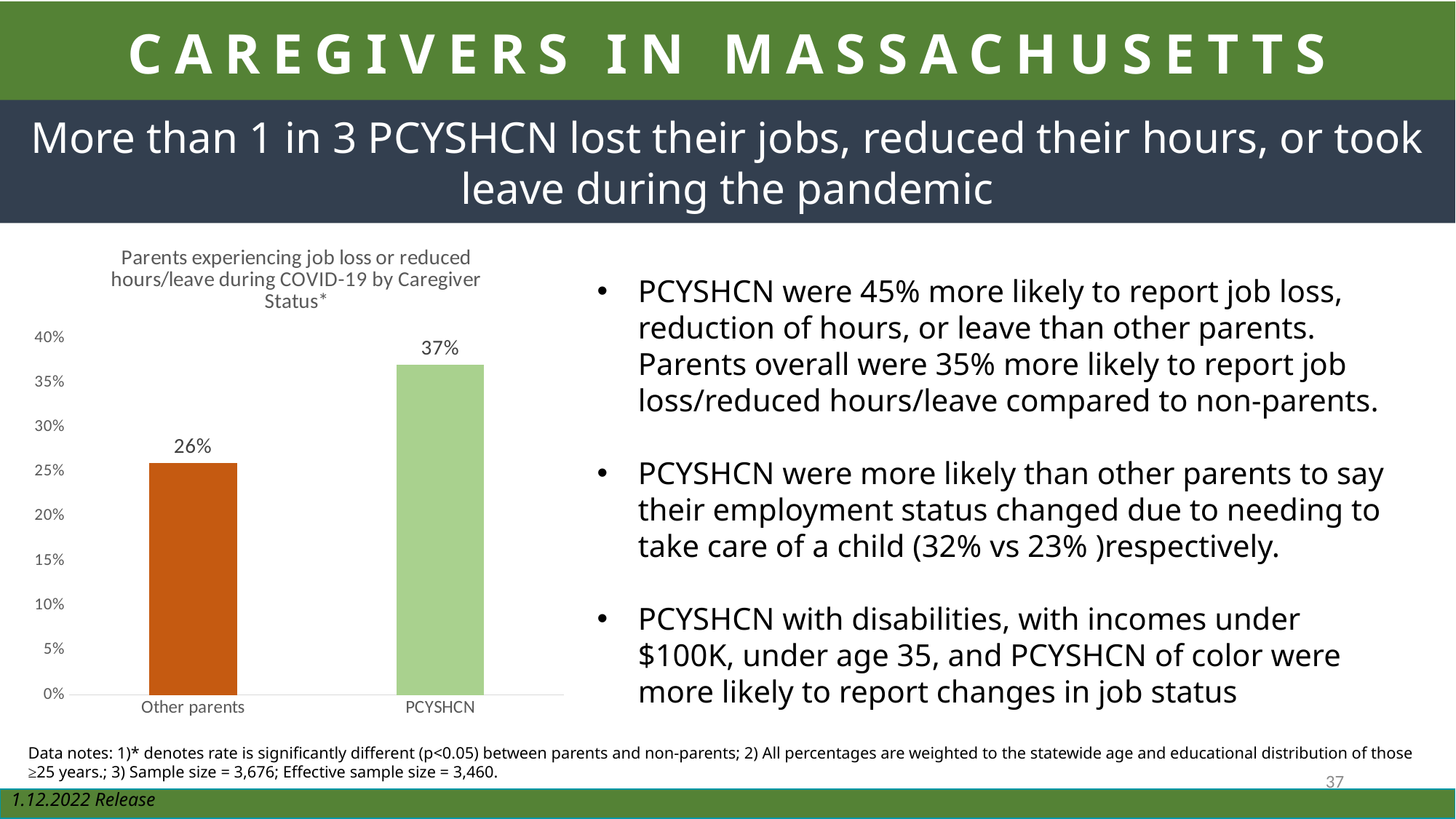
What is the title of the chart? Parents experiencing job loss or reduced hours/leave during COVID-19 by Caregiver Status* How many categories are shown in the chart? 2 What type of chart is shown on the slide? Bar chart What is the difference in percentage points between PCYSHCN and other parents in the chart? 11 percentage points Which caregiver group has the lower rate of job loss or reduced hours/leave? Other parents What percentage of PCYSHCN experienced job loss or reduced hours/leave during COVID-19? 37% Is the value for other parents greater or less than 30%? less What percentage of other parents experienced job loss or reduced hours/leave during COVID-19? 26% What is the maximum value shown on the chart's y-axis? 40% Which caregiver group has the higher rate of job loss or reduced hours/leave? PCYSHCN What colour is the bar for PCYSHCN? Light green Is the value for PCYSHCN greater or less than 35%? greater